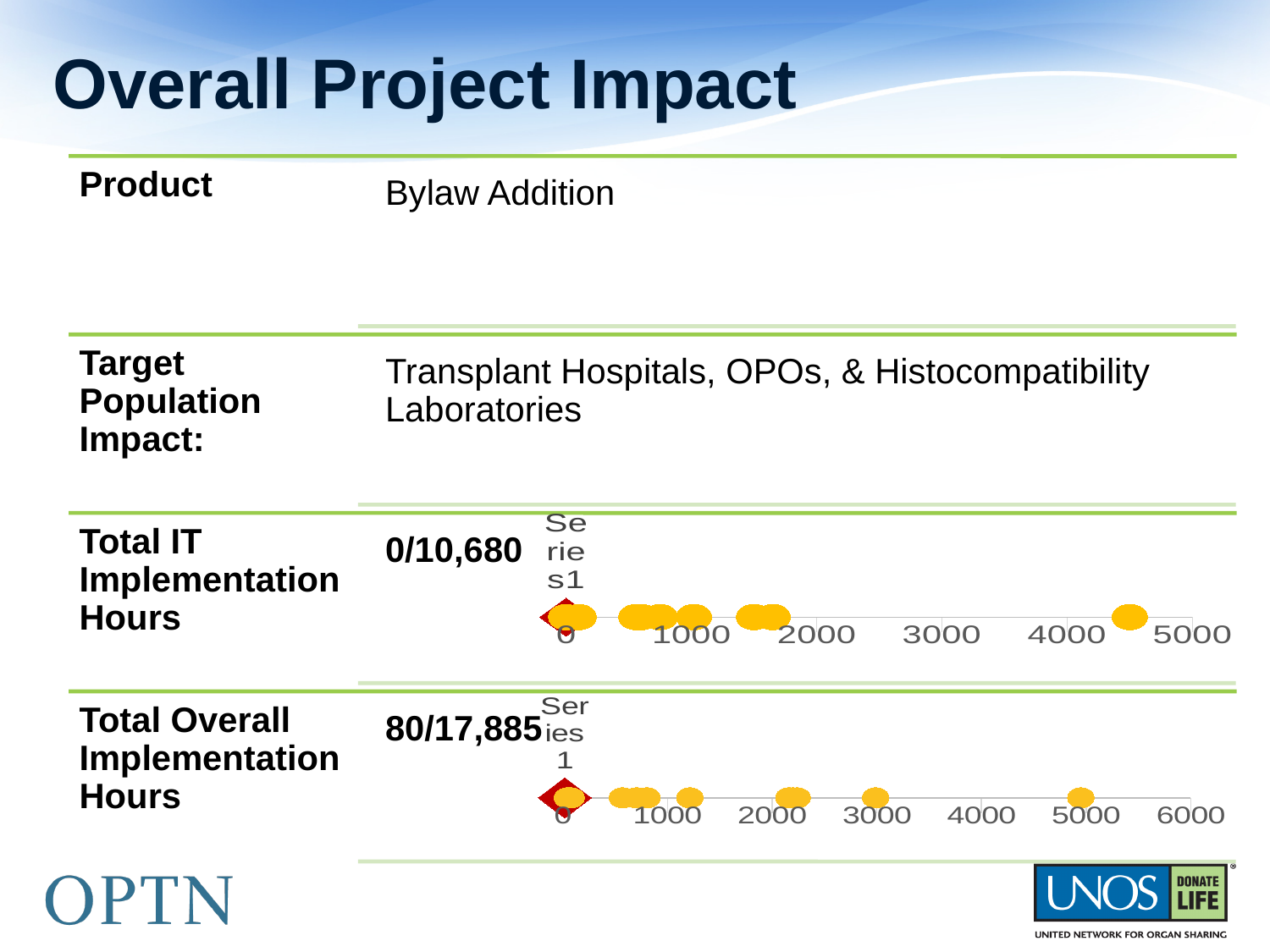
In the chart next to "Total Overall Implementation Hours", is the rightmost yellow point greater or less than 4000? greater In the chart next to "Total IT Implementation Hours", is the rightmost yellow point greater or less than 4000? greater What kind of chart is shown next to "Total IT Implementation Hours"? scatter chart In the chart next to "Total Overall Implementation Hours", is the red diamond marker greater or less than 1000? less What kind of chart is shown next to "Total Overall Implementation Hours"? scatter chart Which chart has a horizontal axis that extends further: the one next to "Total IT Implementation Hours" or the one next to "Total Overall Implementation Hours"? Total Overall Implementation Hours In the chart next to "Total IT Implementation Hours", what is the highest value labelled on the horizontal axis? 5000